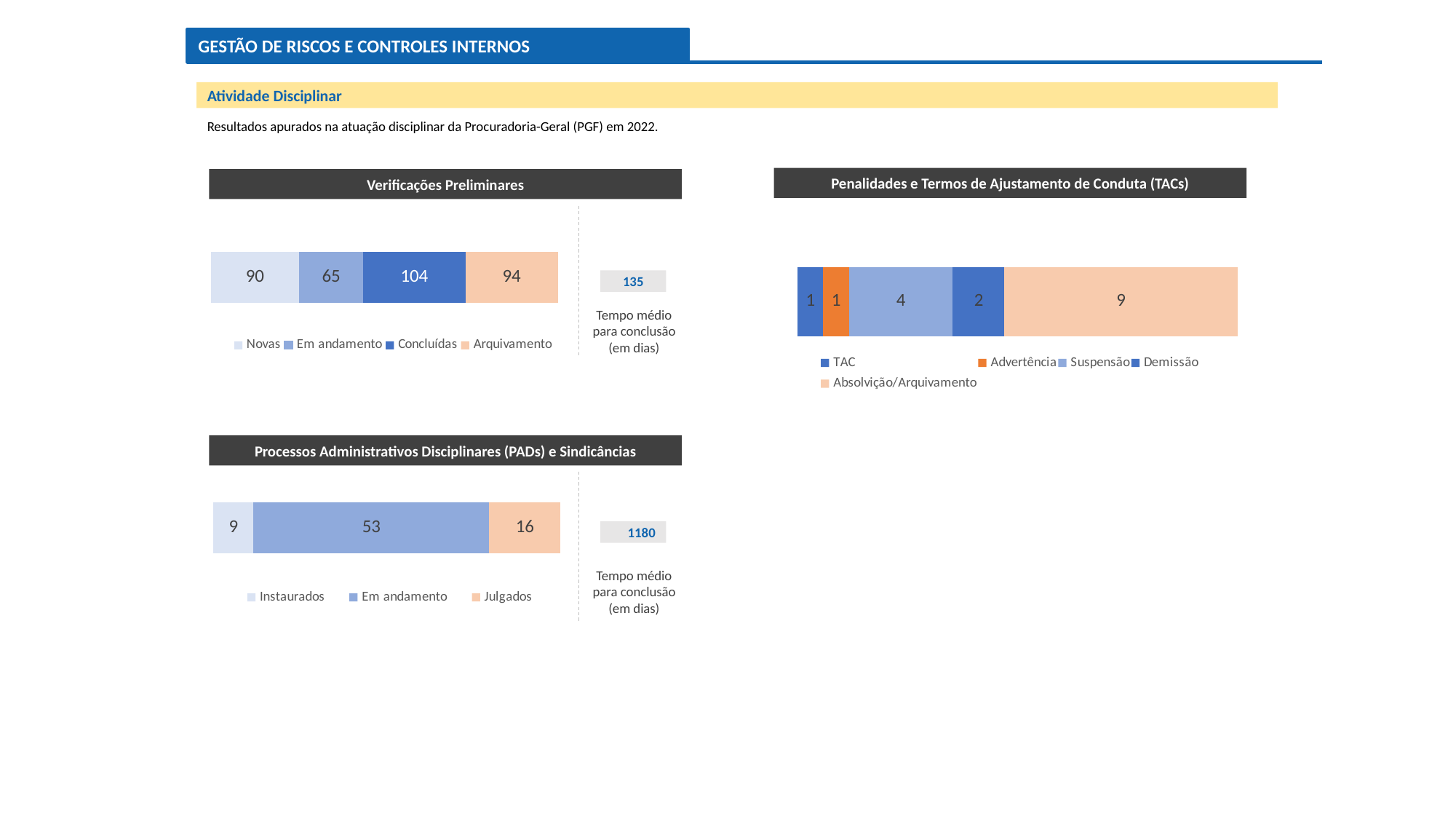
In the 'Penalidades e Termos de Ajustamento de Conduta (TACs)' chart, what is the total of the stacked bar? 17 In the 'Verificações Preliminares' chart, how many series does the legend list? 4 In the 'Processos Administrativos Disciplinares (PADs) e Sindicâncias' chart, which is larger, Instaurados or Julgados? Julgados In the 'Verificações Preliminares' chart, what is the difference between Concluídas and Novas? 14 In the 'Penalidades e Termos de Ajustamento de Conduta (TACs)' chart, how many series does the legend list? 5 In the 'Verificações Preliminares' chart, what is the value for Concluídas? 104 In the 'Penalidades e Termos de Ajustamento de Conduta (TACs)' chart, which series has the highest value? Absolvição/Arquivamento In the 'Verificações Preliminares' chart, what is the total of the stacked bar? 353 In the 'Processos Administrativos Disciplinares (PADs) e Sindicâncias' chart, what is the value for Em andamento? 53 In the 'Penalidades e Termos de Ajustamento de Conduta (TACs)' chart, what is the value for Suspensão? 4 What kind of chart is the 'Processos Administrativos Disciplinares (PADs) e Sindicâncias' chart? Stacked bar chart In the 'Verificações Preliminares' chart, which series has the lowest value? Em andamento